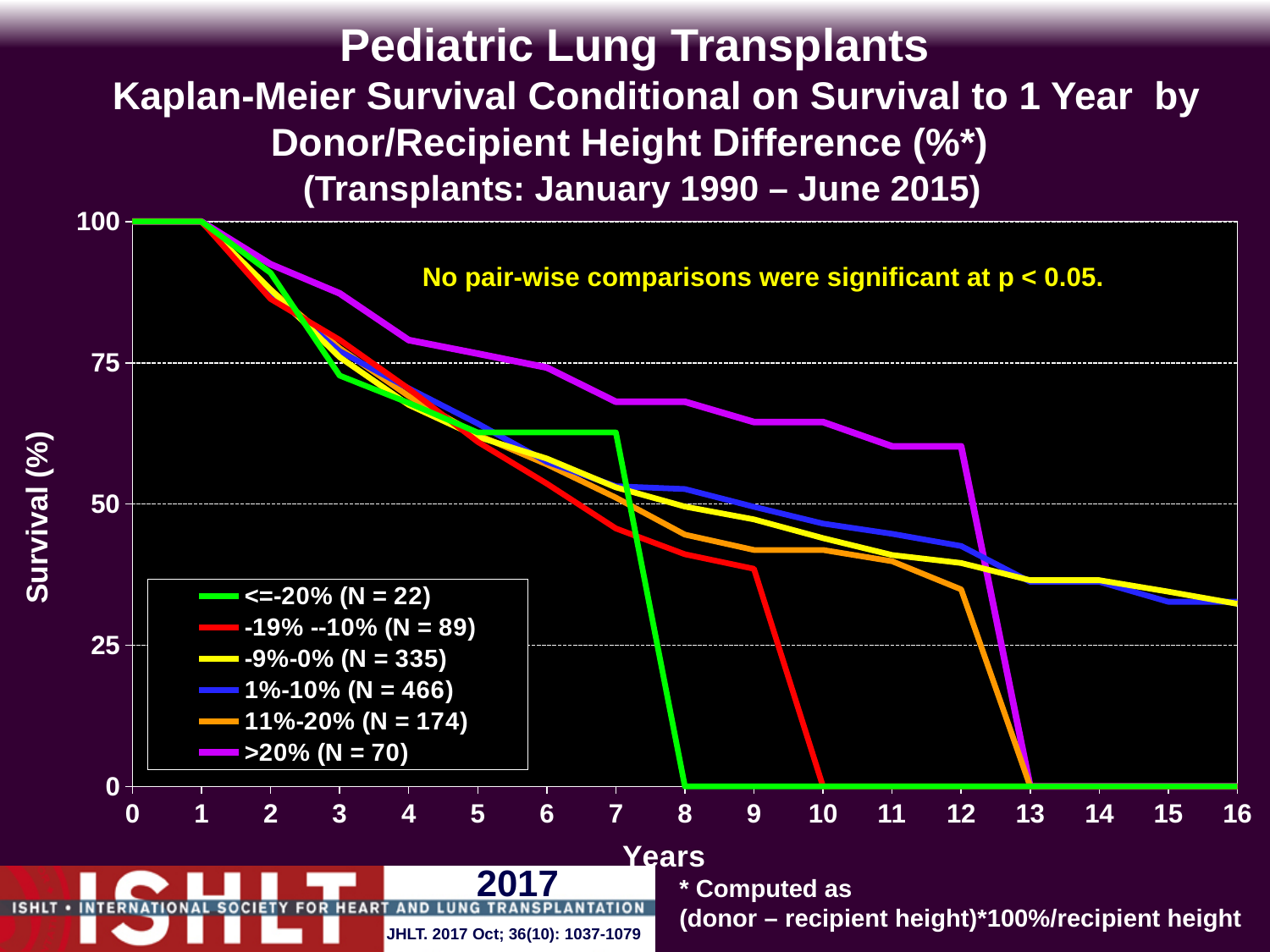
Which group has the largest N in the legend? 1%-10% (N = 466) What is the N for the -9%-0% group shown in the legend? 335 Which group is the first to drop to 0% survival? <=-20% (N = 22) What kind of chart is shown on the slide? Line chart Is the survival value for the -19% --10% group at year 9 greater or less than 50? less What note is printed inside the chart area about pair-wise comparisons? No pair-wise comparisons were significant at p < 0.05. At year 10, which group has higher survival: >20% or 1%-10%? >20% Do the survival curves rise or fall as the years increase? Fall Is the survival value for the -9%-0% group at year 16 greater or less than 25? greater Is the survival value for the >20% group at year 10 greater or less than 50? greater How many series does the legend list? 6 Which group has the highest survival at year 10? >20% (N = 70)